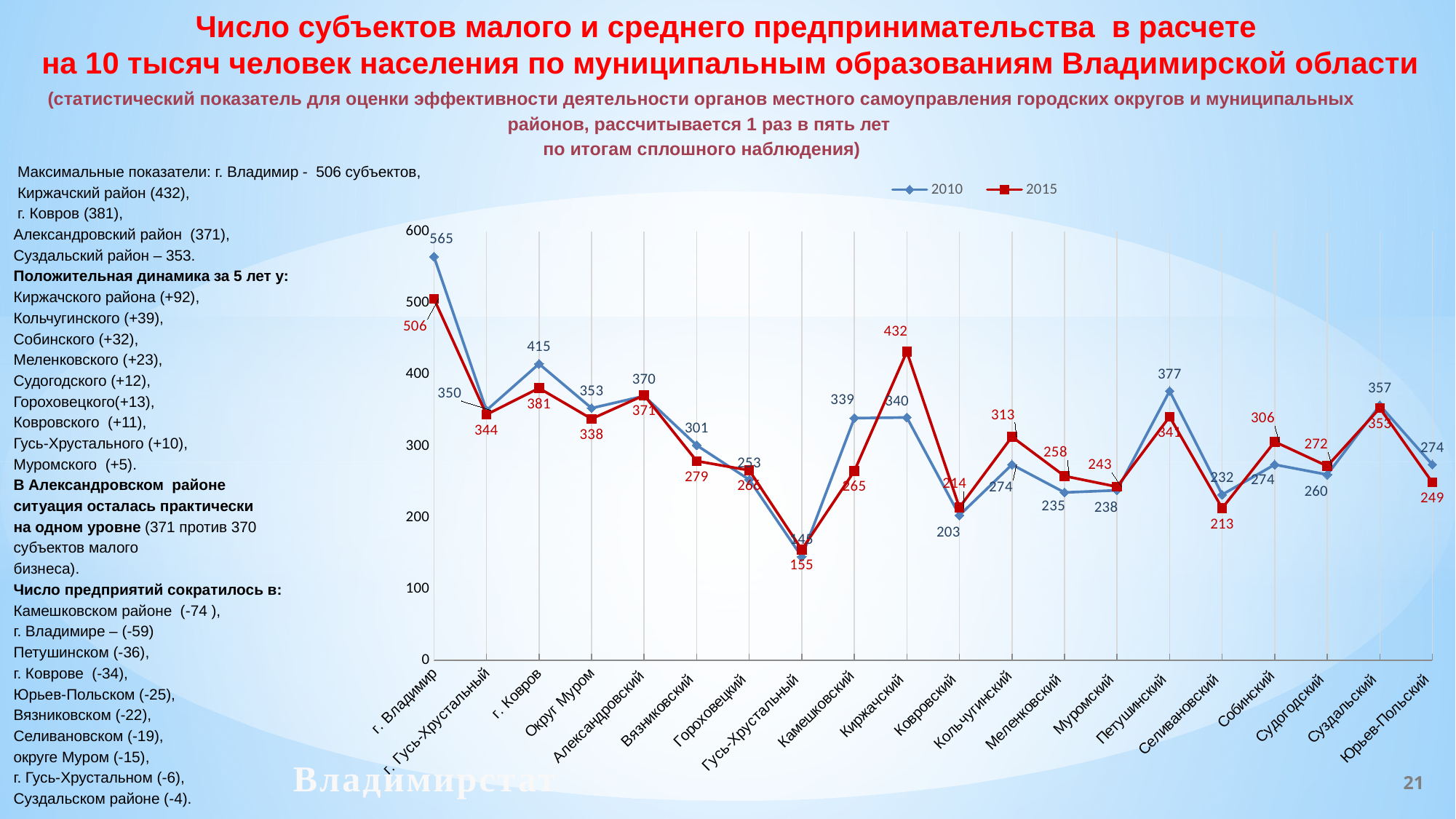
How many municipalities are plotted along the x axis? 20 Which municipality has the highest 2010 value? г. Владимир Which colour is used for the 2015 series? red What is the 2015 value for Киржачский? 432 Is the 2010 value for Ковровский greater or less than 300? less What is the 2015 value for Селивановский? 213 What is the 2010 value for г. Владимир? 565 What kind of chart is shown on the slide? line chart What is the difference between the 2010 and 2015 values for г. Владимир? 59 Which municipality has the lowest 2015 value? Гусь-Хрустальный For Киржачский, which is larger: the 2010 value or the 2015 value? 2015 How many series does the legend list? 2